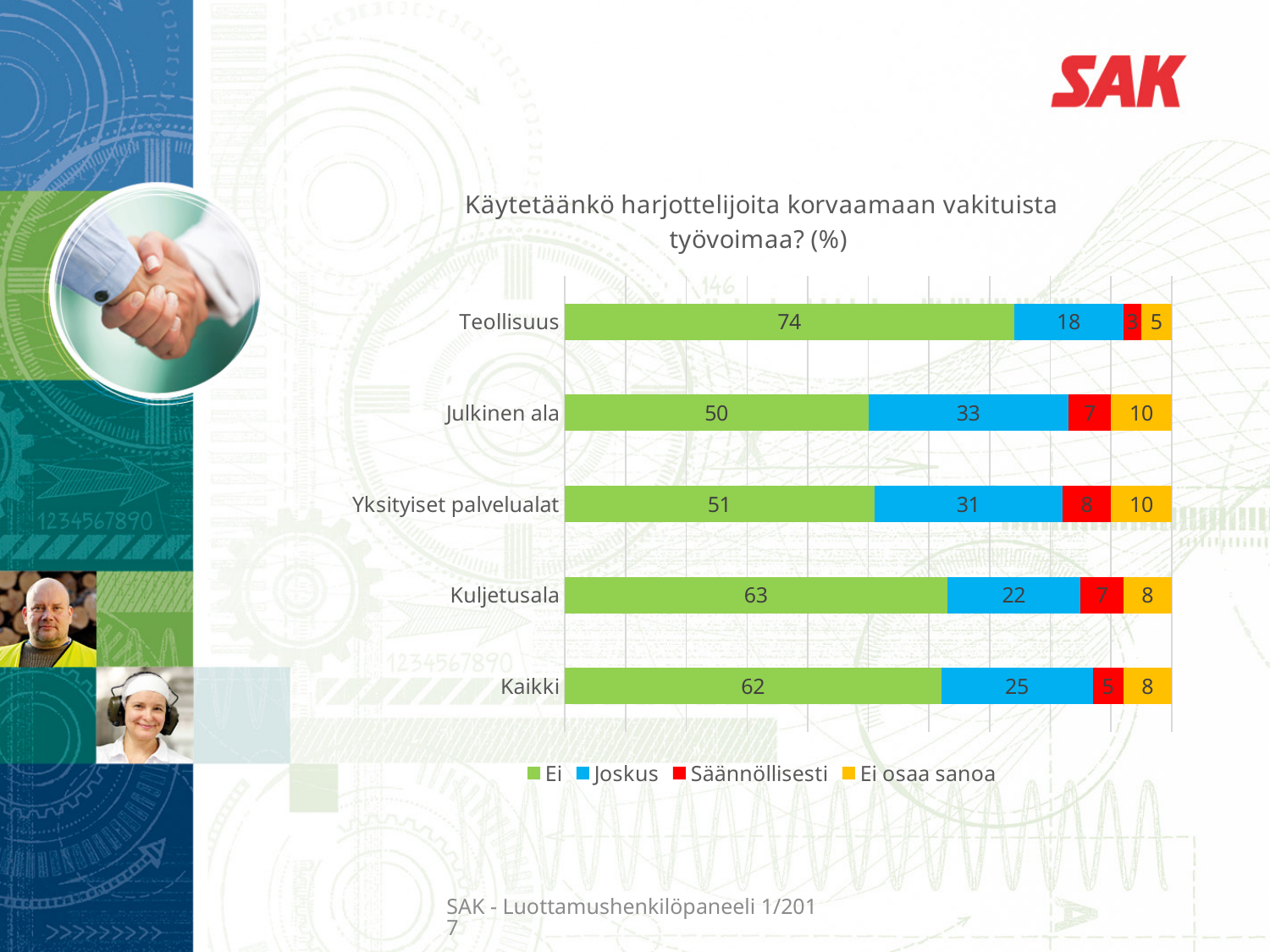
What is the 'Ei' value for Teollisuus? 74 Which is larger, the 'Joskus' value for Kuljetusala or for Kaikki? Kaikki What is the 'Joskus' value for Julkinen ala? 33 What is the 'Ei osaa sanoa' value for Kuljetusala? 8 How many categories are shown on the chart? 5 What is the total of the stacked bar for Julkinen ala? 100 Which category has the lowest 'Ei' value? Julkinen ala Which category has the highest 'Ei' value? Teollisuus What is the 'Säännöllisesti' value for Yksityiset palvelualat? 8 What kind of chart is shown on the slide? Stacked bar chart What is the difference between the 'Ei' values for Teollisuus and Kaikki? 12 How many series does the legend list? 4